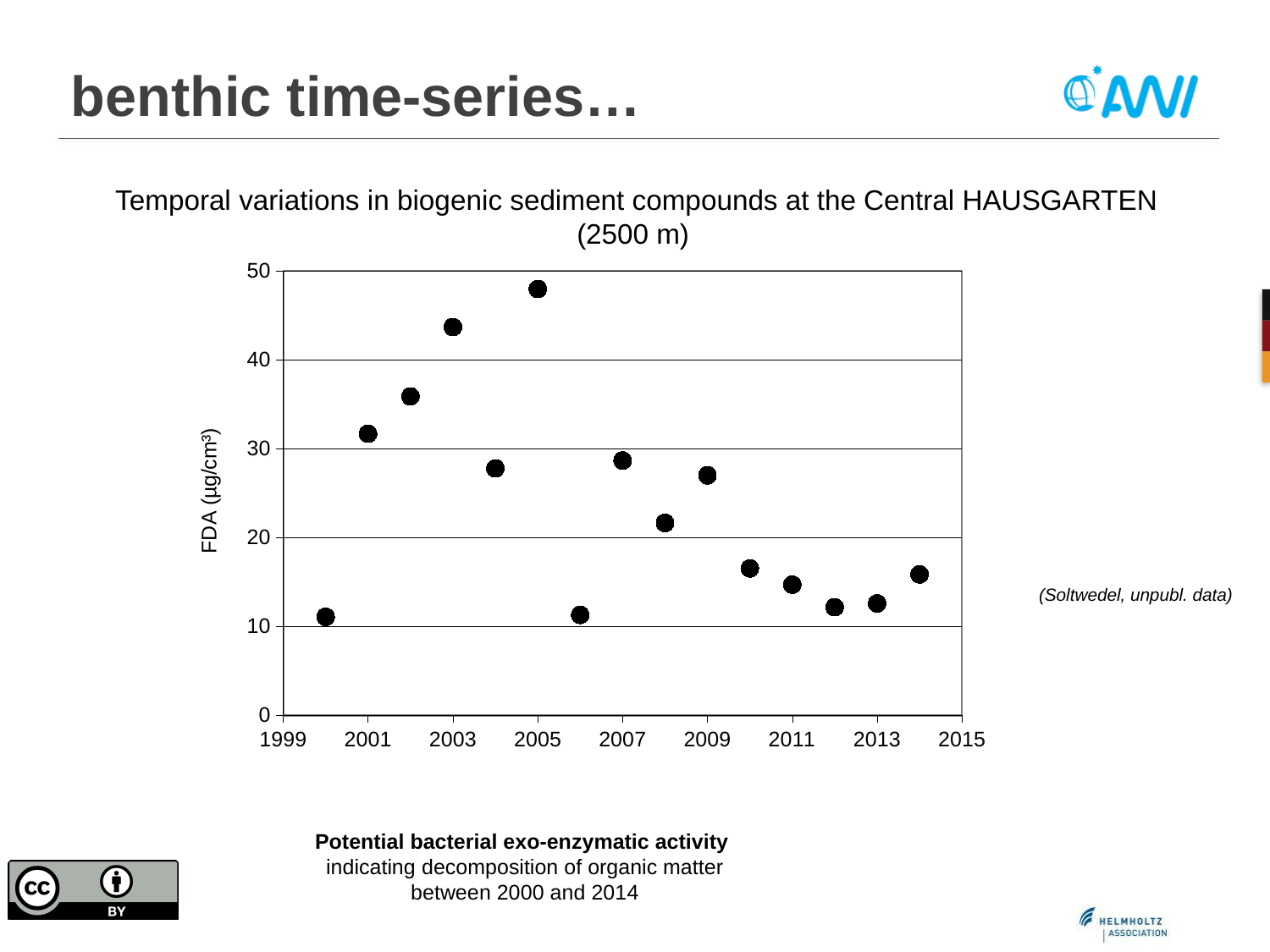
How many data points are plotted in the chart? 15 Between 2009 and 2012, do the FDA values rise or fall? fall Is the FDA value for 2001 greater or less than 30? greater Is the FDA value for 2008 greater or less than 30? less Which year has the larger FDA value, 2003 or 2004? 2003 Which year has the larger FDA value, 2002 or 2010? 2002 What is the label on the y axis of the chart? FDA (µg/cm³) Is the FDA value for 2014 greater or less than 20? less What kind of chart is shown on the slide? scatter chart In which year is the FDA value highest? 2005